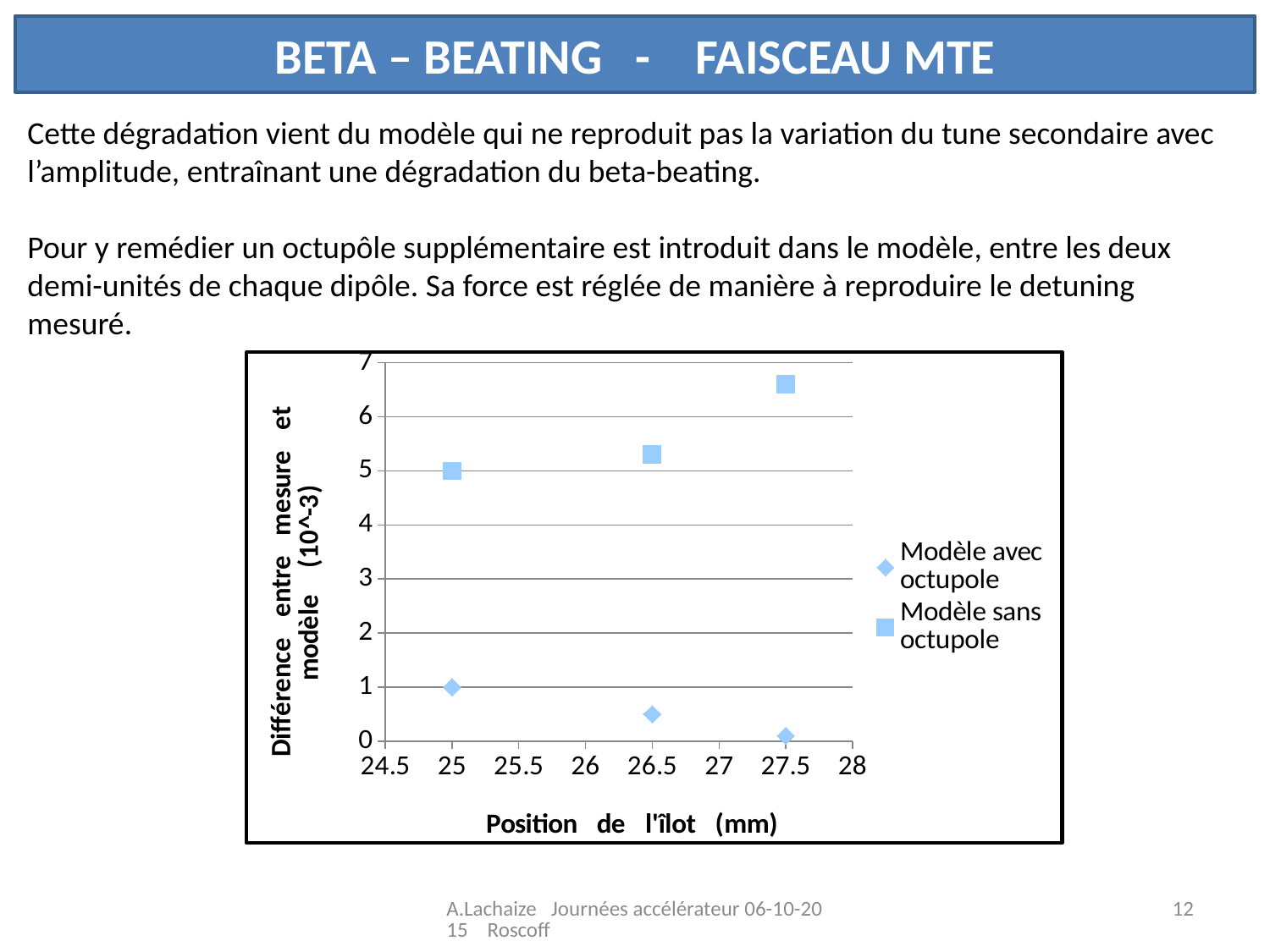
What kind of chart is shown on the slide? scatter chart Is the value for 'Modèle avec octupole' at position 27.5 mm greater or less than 1? less How many data points are plotted for the series 'Modèle sans octupole'? 3 What is the x-axis title of the chart? Position de l'îlot (mm) At which position is the value for 'Modèle avec octupole' lowest? 27.5 How many series does the legend list? 2 Is the value for 'Modèle sans octupole' at position 27.5 mm greater or less than 6? greater Is the value for 'Modèle sans octupole' at position 26.5 mm greater or less than 5? greater What is the value for 'Modèle avec octupole' at position 25 mm? 1 Do the values for 'Modèle avec octupole' rise or fall as the position increases? fall At which position is the value for 'Modèle sans octupole' highest? 27.5 What is the value for 'Modèle sans octupole' at position 25 mm? 5